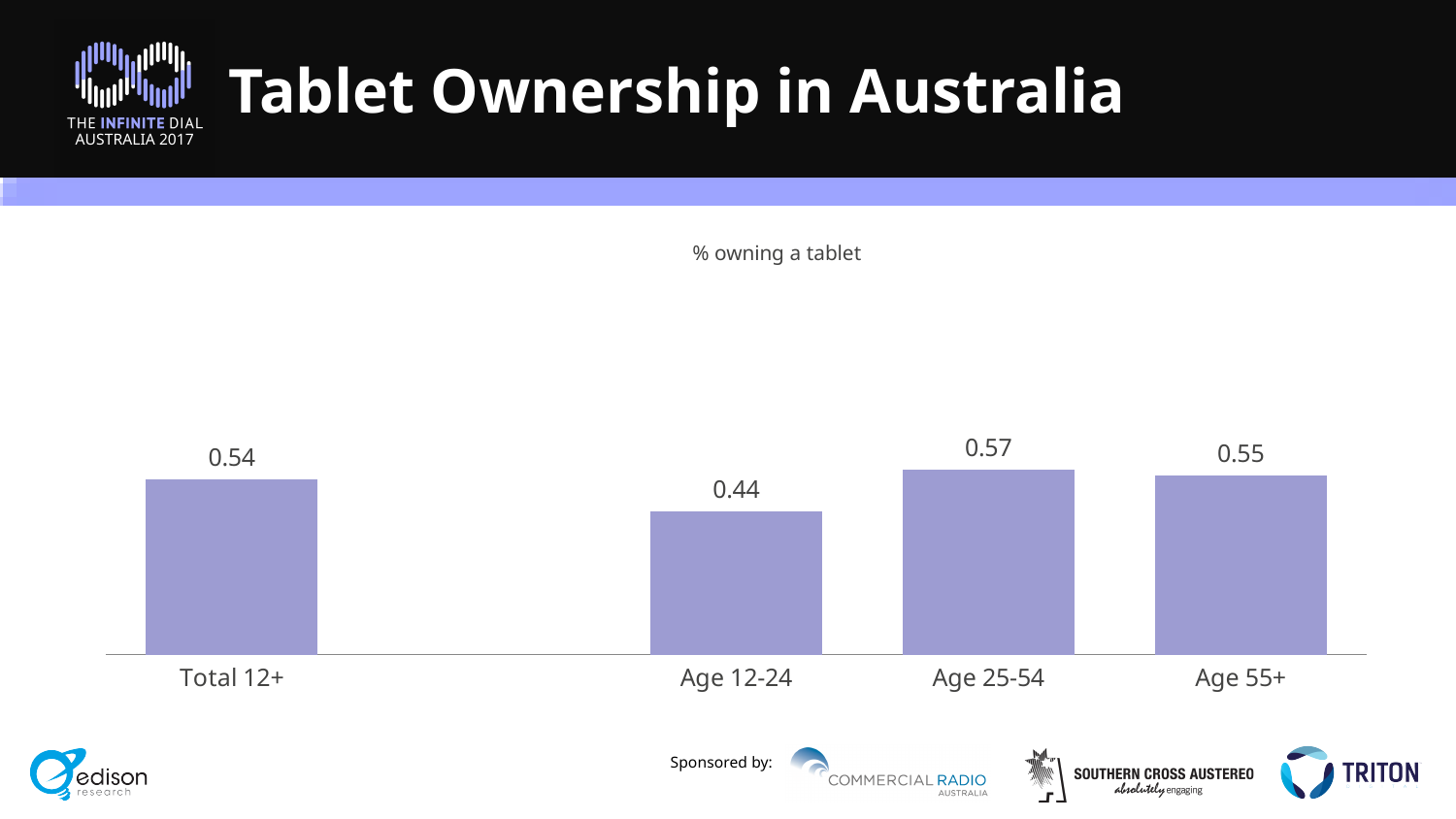
What is the difference between the values for Age 25-54 and Age 12-24? 0.13 Which category has the highest value? Age 25-54 What is the value for Age 25-54? 0.57 Which is larger, the value for Total 12+ or the value for Age 12-24? Total 12+ What is the subtitle shown above the chart? % owning a tablet What is the value for Total 12+? 0.54 How many categories are shown in the chart? 4 What kind of chart is shown on the slide? Bar chart What is the value for Age 55+? 0.55 What is the difference between the values for Age 55+ and Total 12+? 0.01 What is the value for Age 12-24? 0.44 Which category has the lowest value? Age 12-24